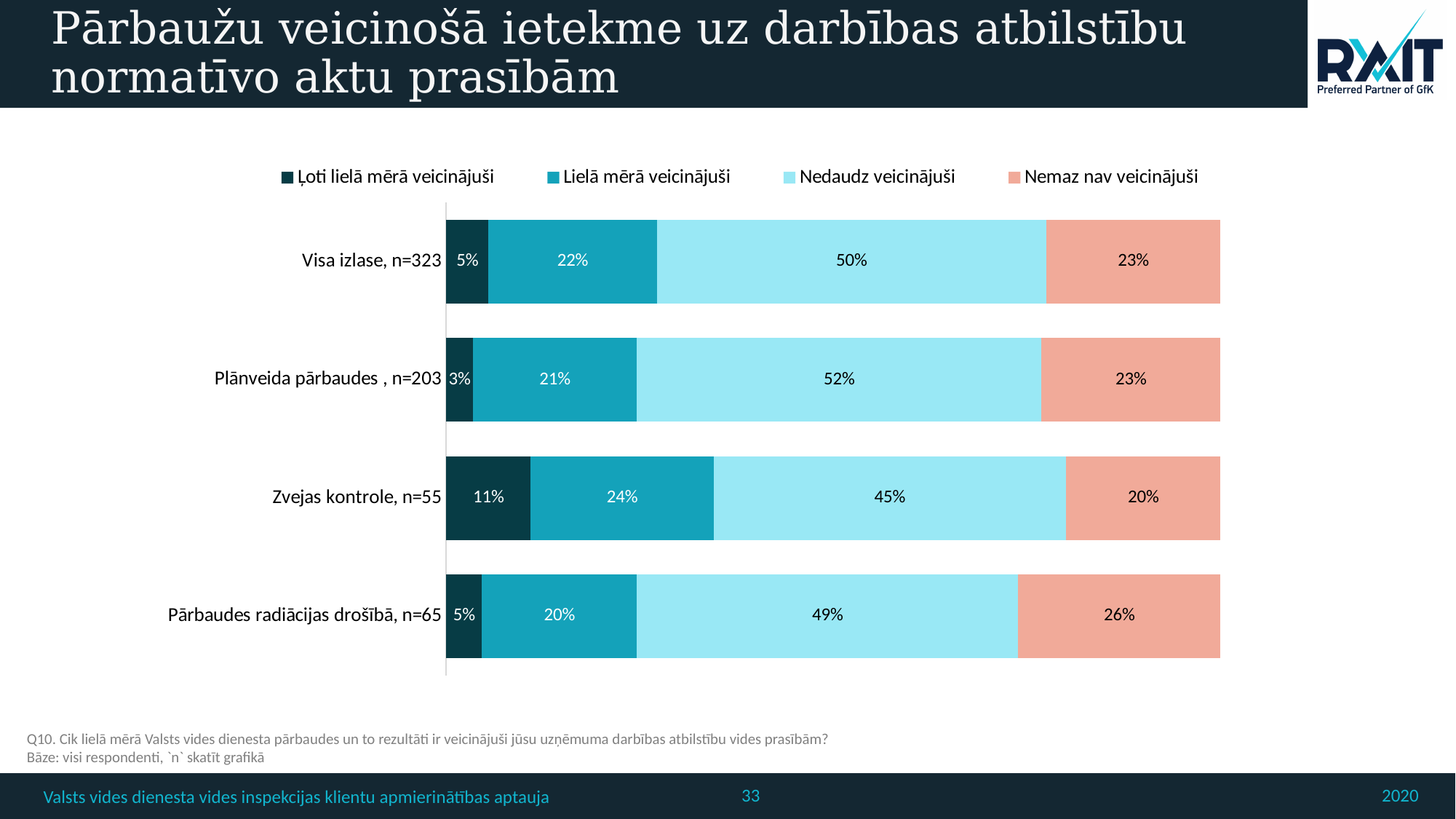
What is the difference between the 'Nedaudz veicinājuši' values for 'Plānveida pārbaudes , n=203' and 'Zvejas kontrole, n=55'? 7 percentage points What is the 'Nemaz nav veicinājuši' value for 'Pārbaudes radiācijas drošībā, n=65'? 26% Which category has the highest 'Ļoti lielā mērā veicinājuši' share? Zvejas kontrole, n=55 What is the 'Ļoti lielā mērā veicinājuši' value for 'Zvejas kontrole, n=55'? 11% What is the 'Lielā mērā veicinājuši' value for 'Plānveida pārbaudes , n=203'? 21% What percentage of 'Visa izlase, n=323' answered 'Nedaudz veicinājuši'? 50% How many categories (bars) are shown in the chart? 4 What kind of chart is shown on the slide? Stacked bar chart Which category has the lowest 'Nemaz nav veicinājuši' share? Zvejas kontrole, n=55 Which is larger: the 'Lielā mērā veicinājuši' value for 'Zvejas kontrole, n=55' or for 'Pārbaudes radiācijas drošībā, n=65'? Zvejas kontrole, n=55 What is the combined share of 'Ļoti lielā mērā veicinājuši' and 'Lielā mērā veicinājuši' for 'Zvejas kontrole, n=55'? 35% How many series does the legend list? 4